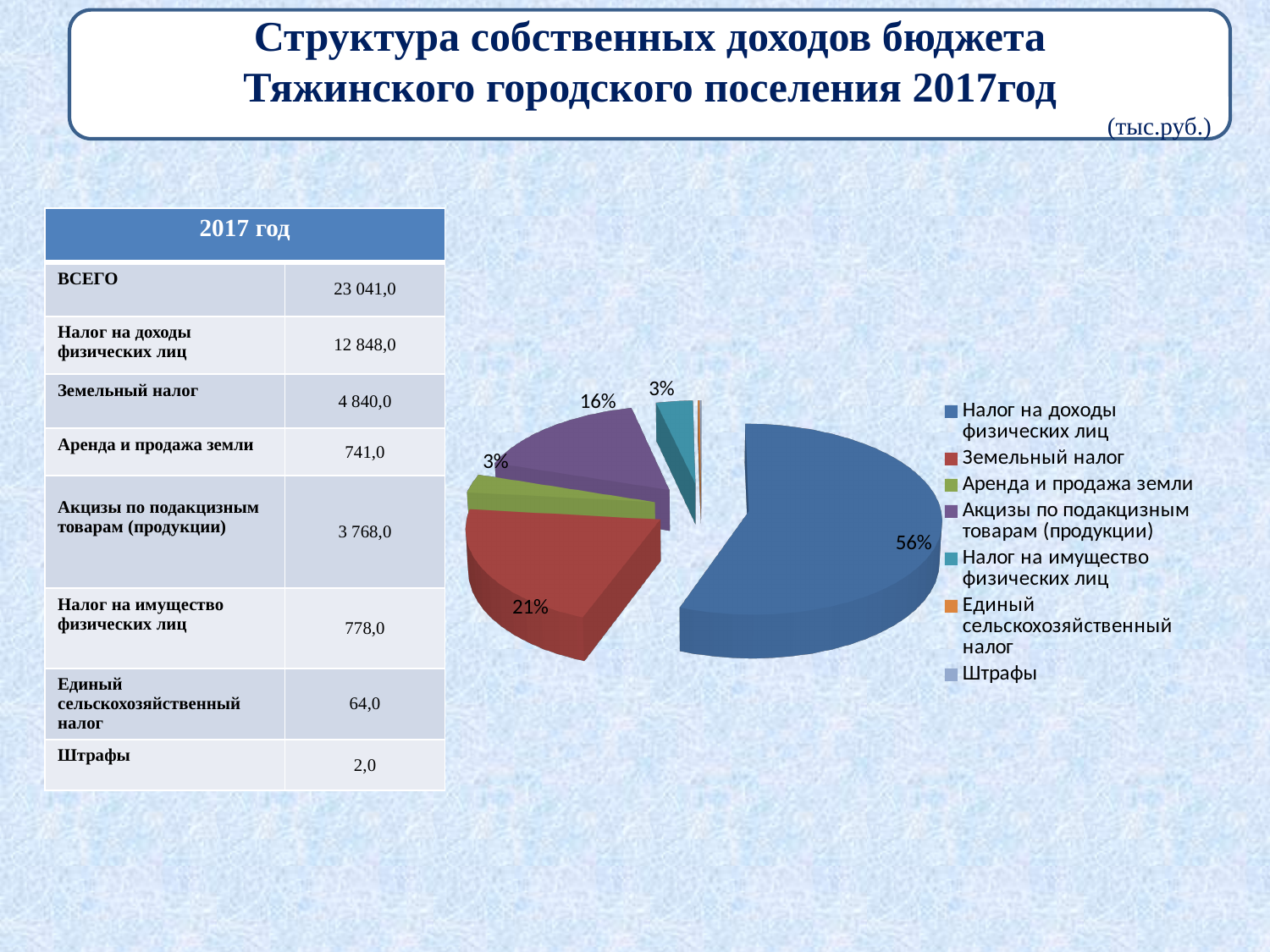
What share of the pie does Земельный налог have? 21% Which slice is larger: Земельный налог or Акцизы по подакцизным товарам (продукции)? Земельный налог What colour is the slice for Акцизы по подакцизным товарам (продукции)? purple What share of the pie does Акцизы по подакцизным товарам (продукции) have? 16% What share of the pie does Налог на имущество физических лиц have? 3% Which legend entry is shown in red? Земельный налог How many categories does the pie chart legend list? 7 By how many percentage points does the Налог на доходы физических лиц slice exceed the Земельный налог slice? 35 percentage points What kind of chart is shown on the slide? pie chart Which category has the largest slice of the pie? Налог на доходы физических лиц